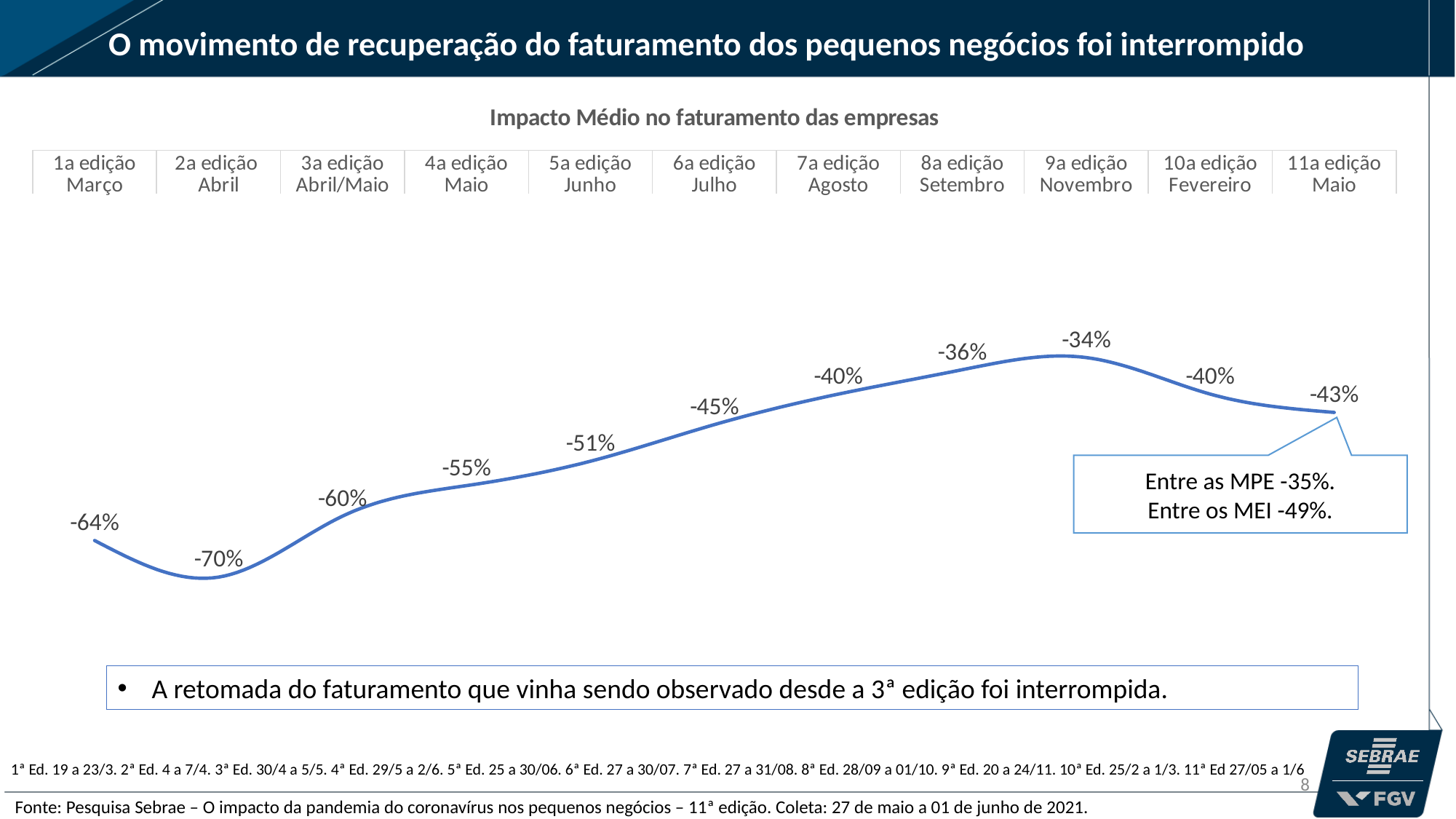
Which edition has the highest value? 9a edição (Novembro) Do the values rise or fall from the 2a edição (Abril) to the 9a edição (Novembro)? Rise What is the value for the 9a edição (Novembro)? -34% What kind of chart is shown on the slide? Line chart What is the value for the 11a edição (Maio)? -43% What is the difference between the value for the 9a edição (Novembro) and the 11a edição (Maio)? 9 percentage points What is the value for the 1a edição (Março)? -64% How many editions are plotted on the chart? 11 What is the difference between the value for the 1a edição (Março) and the 2a edição (Abril)? 6 percentage points What is the title of the chart? Impacto Médio no faturamento das empresas Which edition has the lowest value? 2a edição (Abril) Which is larger, the value for the 5a edição (Junho) or the 6a edição (Julho)? 6a edição (Julho)